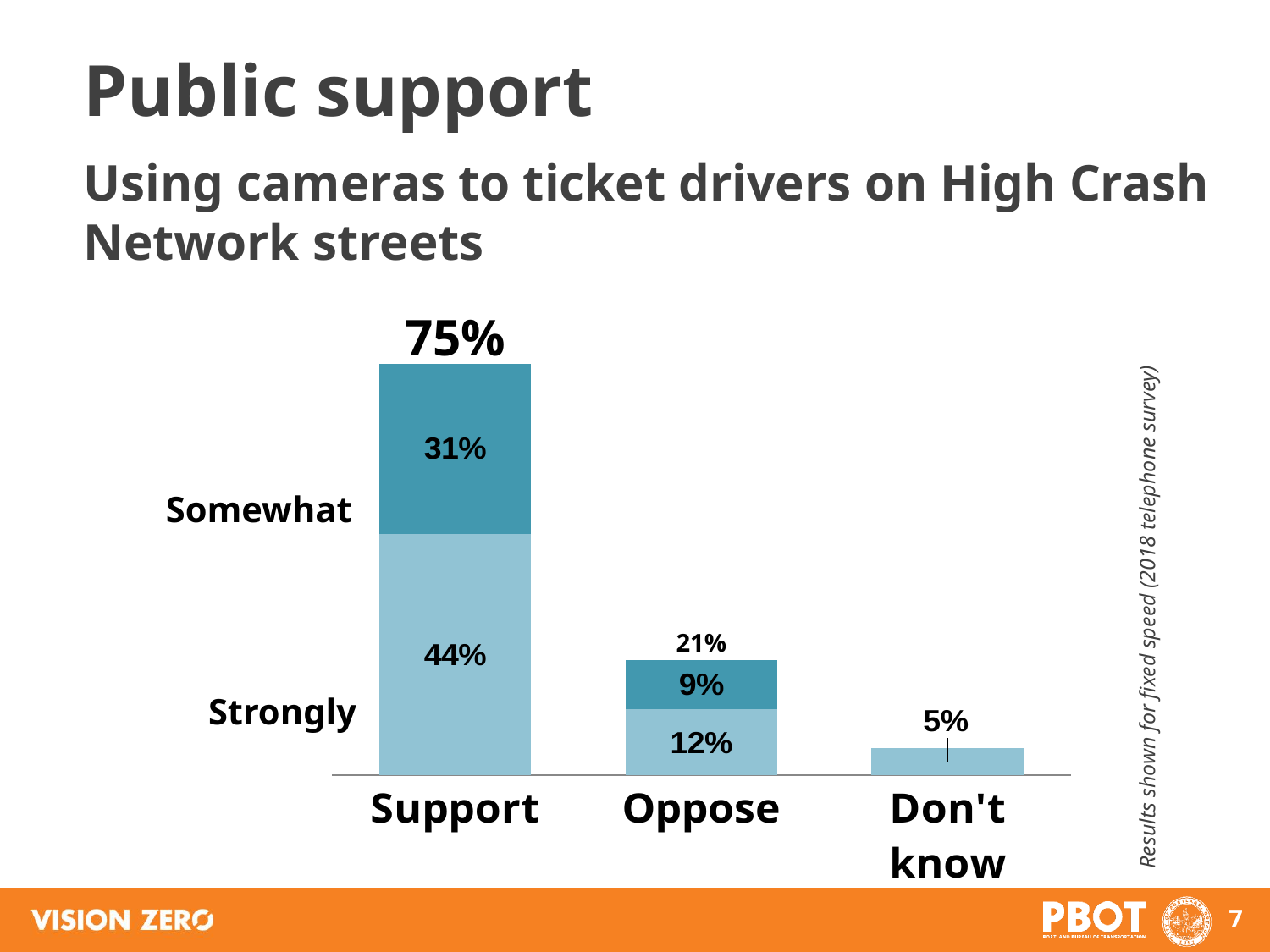
What is the Somewhat value for Support? 31% What is the Somewhat value for Oppose? 9% What is the value for Don't know? 5% What is the Strongly value for Support? 44% Which is larger, the Strongly value for Support or the Strongly value for Oppose? Support What is the Strongly value for Oppose? 12% Which category has the lowest total? Don't know Which category has the highest total? Support What kind of chart is shown on the slide? Stacked bar chart What is the total value shown above the Support bar? 75% How many categories are shown on the x axis? 3 What is the difference between the Support total and the Oppose total? 54%